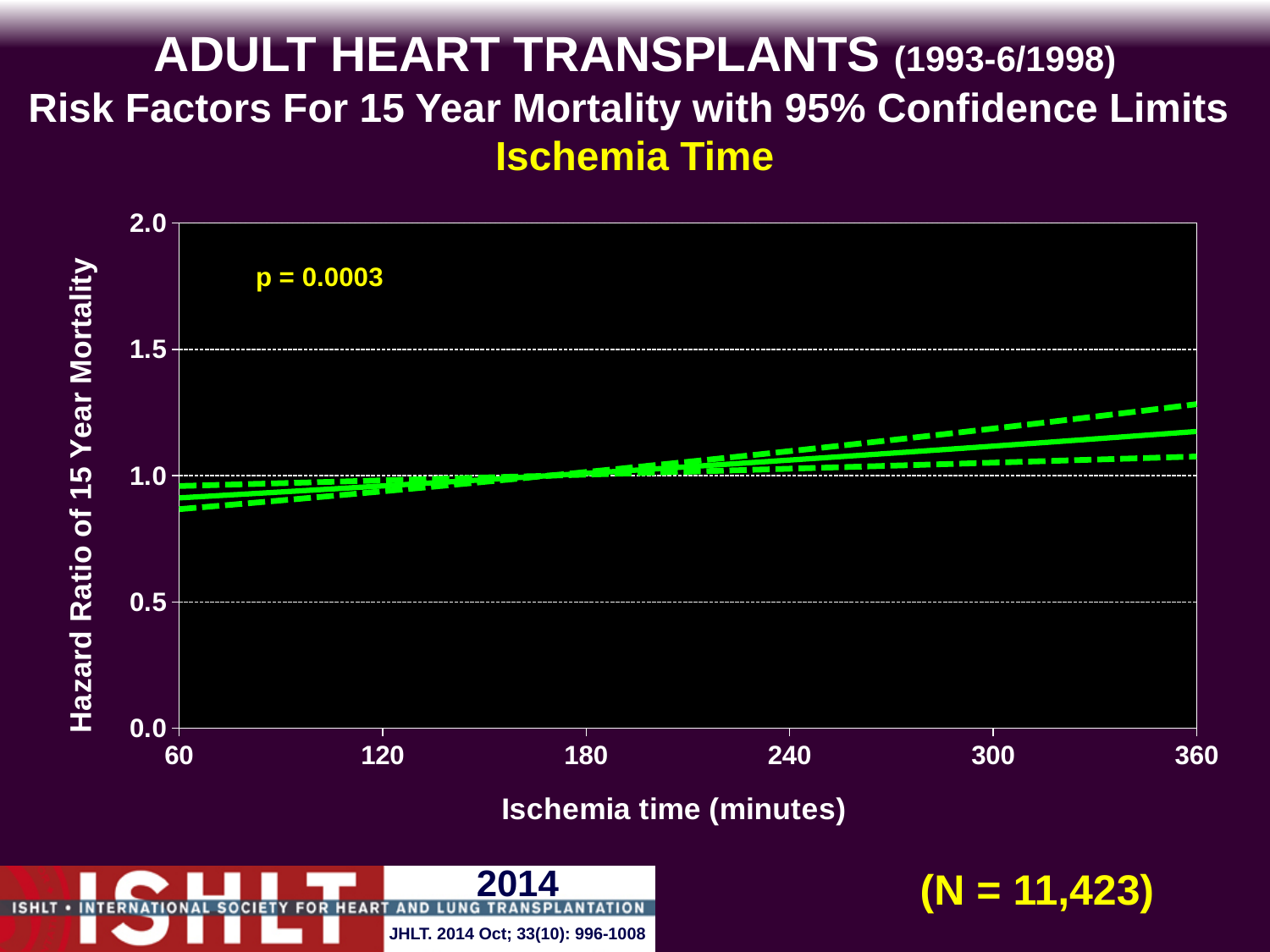
Is the hazard ratio (solid line) at an ischemia time of 360 minutes greater or less than 1.0? greater How many lines are plotted on the chart? 3 Does the hazard ratio of 15 year mortality rise or fall as ischemia time increases from 60 to 360 minutes? rise What is the p-value shown on the chart? p = 0.0003 Is the hazard ratio (solid line) at an ischemia time of 60 minutes greater or less than 1.0? less Is the lower 95% confidence limit at an ischemia time of 60 minutes greater or less than 0.5? greater What is the highest value shown on the y axis? 2.0 What is the sample size (N) shown on the slide? N = 11,423 What kind of chart is shown on the slide? line chart What is the label of the x axis? Ischemia time (minutes)